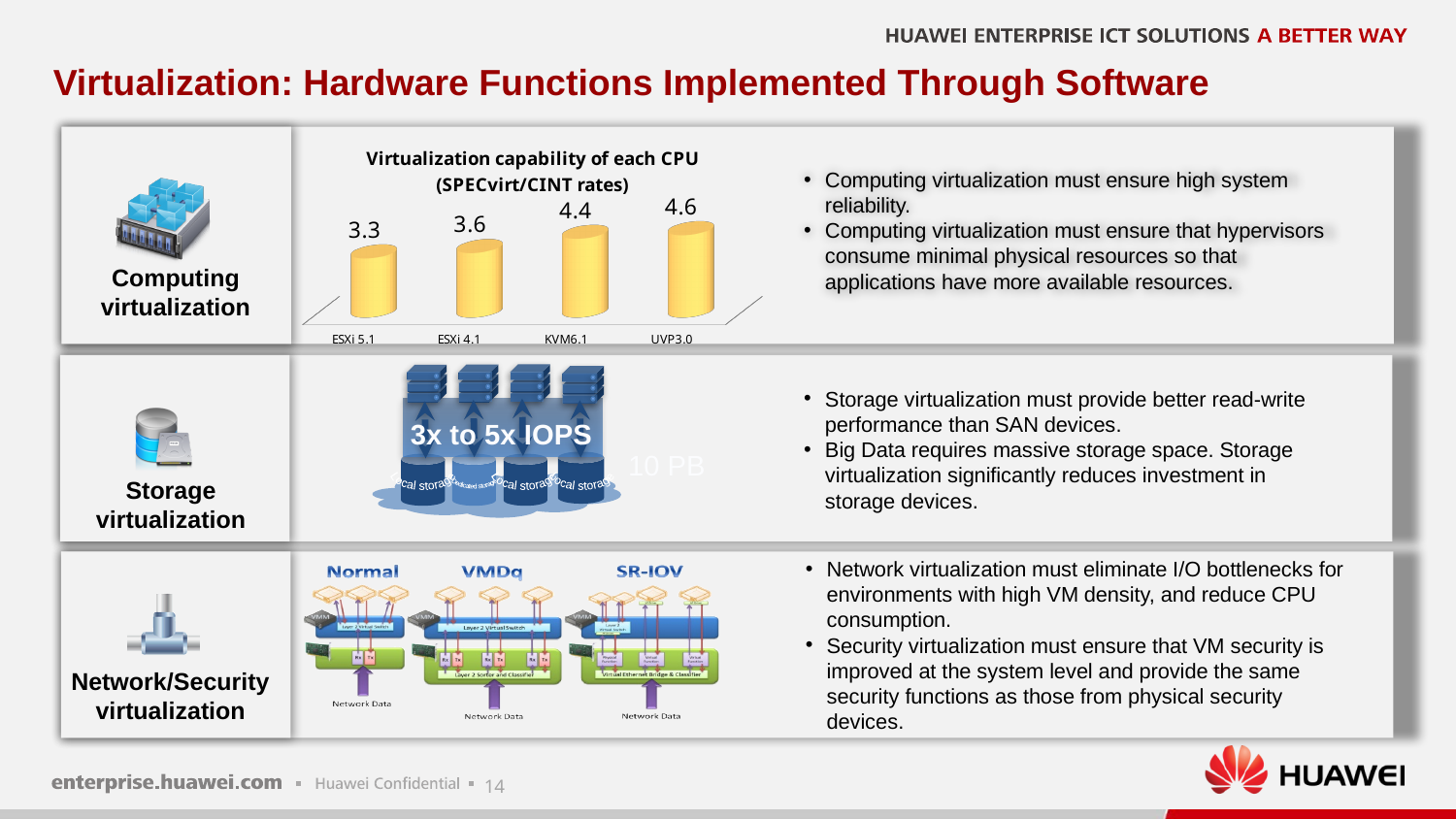
What is the value for KVM6.1 in the chart titled "Virtualization capability of each CPU (SPECvirt/CINT rates)"? 4.4 What is the value for ESXi 4.1 in the chart titled "Virtualization capability of each CPU (SPECvirt/CINT rates)"? 3.6 In the chart titled "Virtualization capability of each CPU (SPECvirt/CINT rates)", which category has the highest value? UVP3.0 In the chart titled "Virtualization capability of each CPU (SPECvirt/CINT rates)", what is the difference between the values for UVP3.0 and ESXi 5.1? 1.3 How many categories are shown in the chart titled "Virtualization capability of each CPU (SPECvirt/CINT rates)"? 4 What is the value for UVP3.0 in the chart titled "Virtualization capability of each CPU (SPECvirt/CINT rates)"? 4.6 In the chart titled "Virtualization capability of each CPU (SPECvirt/CINT rates)", do the values rise or fall from left to right along the x axis? Rise In the chart titled "Virtualization capability of each CPU (SPECvirt/CINT rates)", which category has the lowest value? ESXi 5.1 In the chart titled "Virtualization capability of each CPU (SPECvirt/CINT rates)", what is the difference between the values for KVM6.1 and ESXi 4.1? 0.8 What kind of chart is the one titled "Virtualization capability of each CPU (SPECvirt/CINT rates)"? Bar chart In the chart titled "Virtualization capability of each CPU (SPECvirt/CINT rates)", which is larger, the value for ESXi 4.1 or the value for KVM6.1? KVM6.1 What is the value for ESXi 5.1 in the chart titled "Virtualization capability of each CPU (SPECvirt/CINT rates)"? 3.3